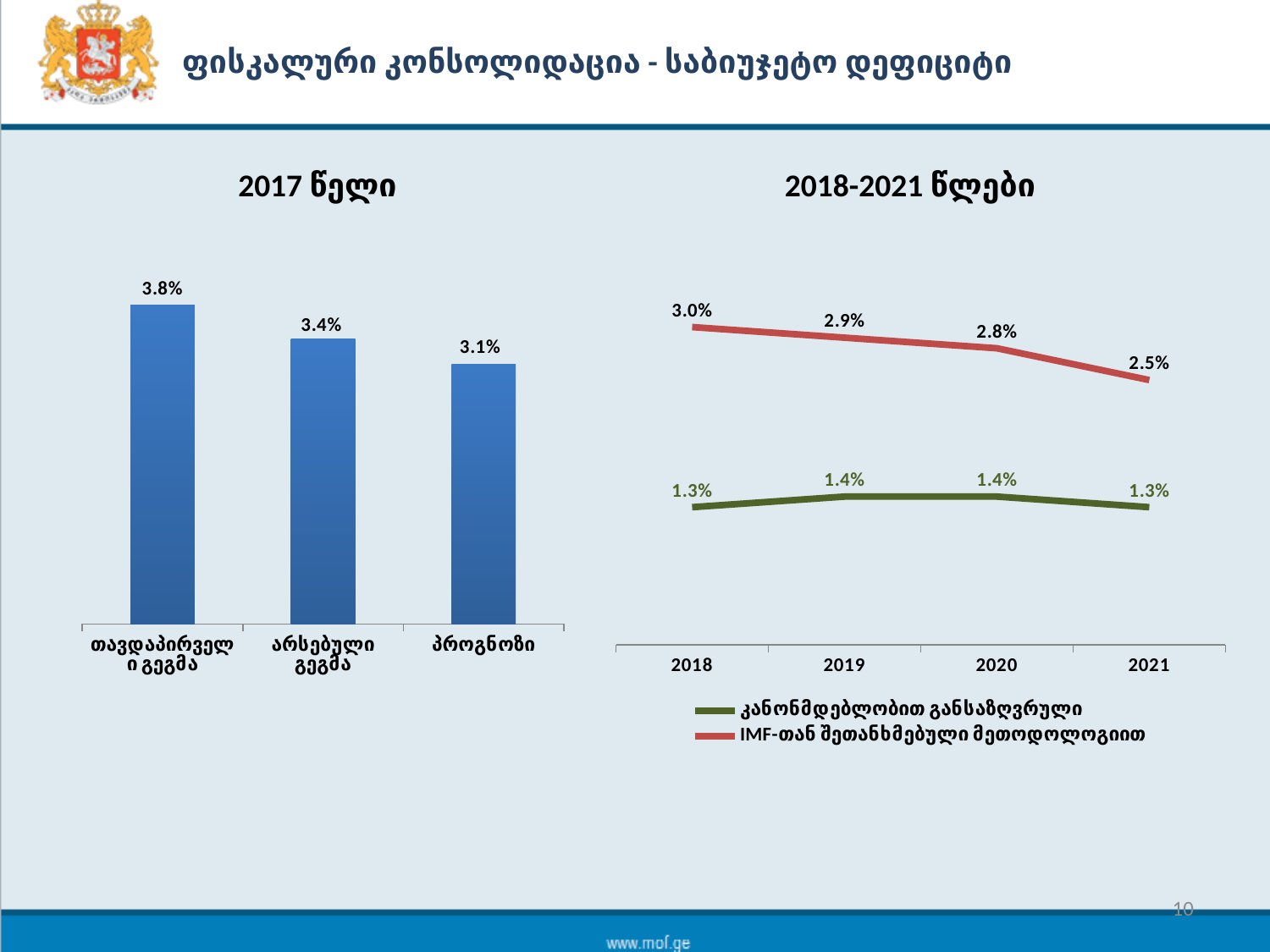
In the right chart (2018-2021 წლები), what is the value of the IMF-თან შეთანხმებული მეთოდოლოგიით series in 2021? 2.5% In the left chart (2017 წელი), which category has the lowest value? პროგნოზი In the left chart (2017 წელი), what is the value for თავდაპირველი გეგმა? 3.8% In the right chart (2018-2021 წლები), what is the difference between the two series in 2018? 1.7% In the left chart (2017 წელი), what is the value for პროგნოზი? 3.1% In the right chart (2018-2021 წლები), what is the value of the კანონმდებლობით განსაზღვრული series in 2019? 1.4% How many categories are shown in the left chart (2017 წელი)? 3 What kind of chart is the left chart (2017 წელი)? Bar chart In the right chart (2018-2021 წლები), which series is shown in red? IMF-თან შეთანხმებული მეთოდოლოგიით How many series does the legend of the right chart (2018-2021 წლები) list? 2 In the left chart (2017 წელი), what is the difference between თავდაპირველი გეგმა and არსებული გეგმა? 0.4% In the right chart (2018-2021 წლები), does the IMF-თან შეთანხმებული მეთოდოლოგიით series rise or fall from 2018 to 2021? Fall